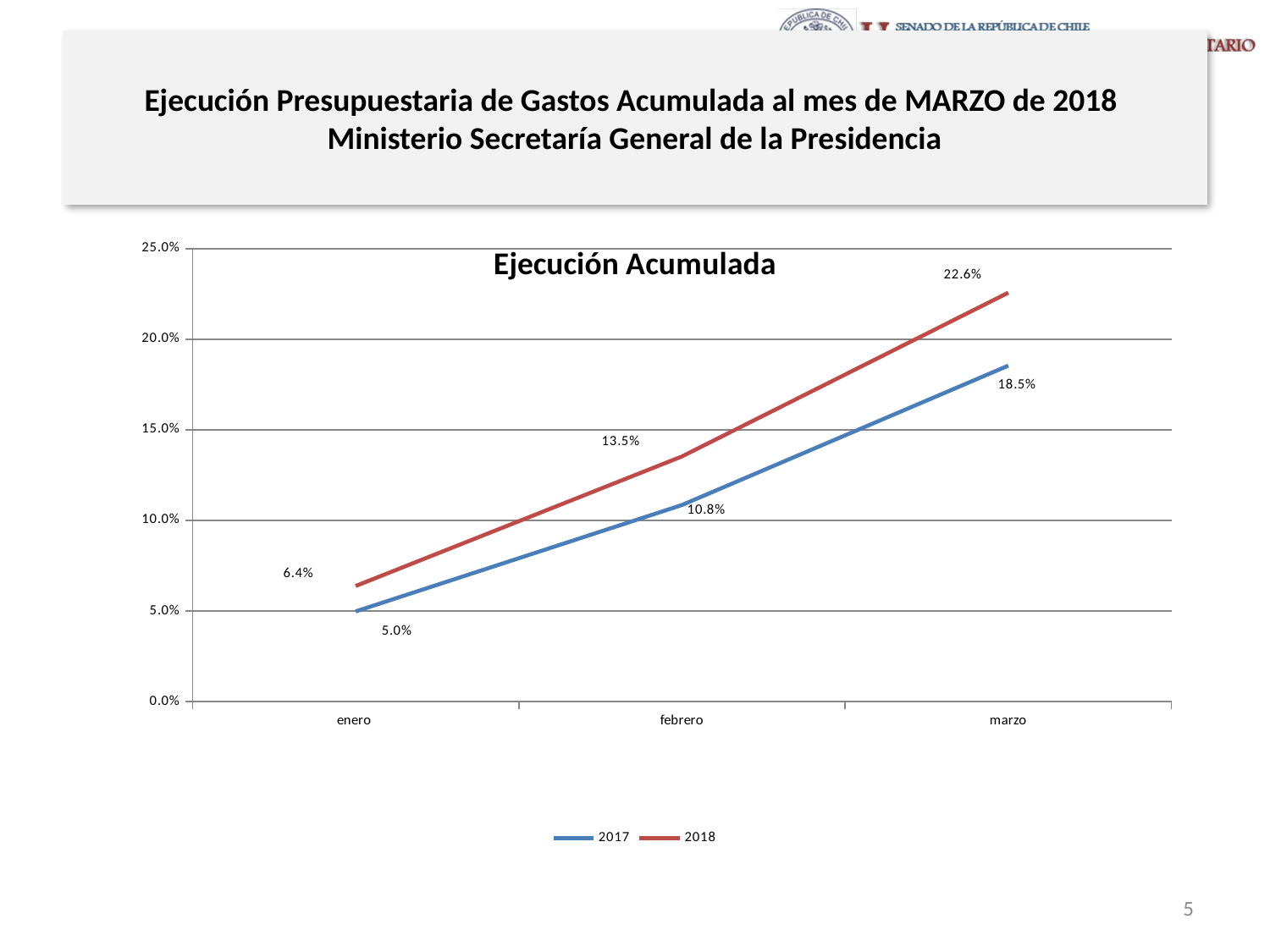
What kind of chart is shown? line chart What is the difference between the 2018 and 2017 values in marzo? 4.1% Which series has the larger value in febrero, 2017 or 2018? 2018 How many series does the legend list? 2 What is the value for 2017 in febrero? 10.8% How many months are shown on the x axis? 3 In which month is the 2018 series highest? marzo What is the value for 2018 in marzo? 22.6% What is the value for 2018 in enero? 6.4% What is the value for 2017 in enero? 5.0% In which month is the 2017 series lowest? enero Is the value for 2017 in marzo greater or less than 20.0%? less